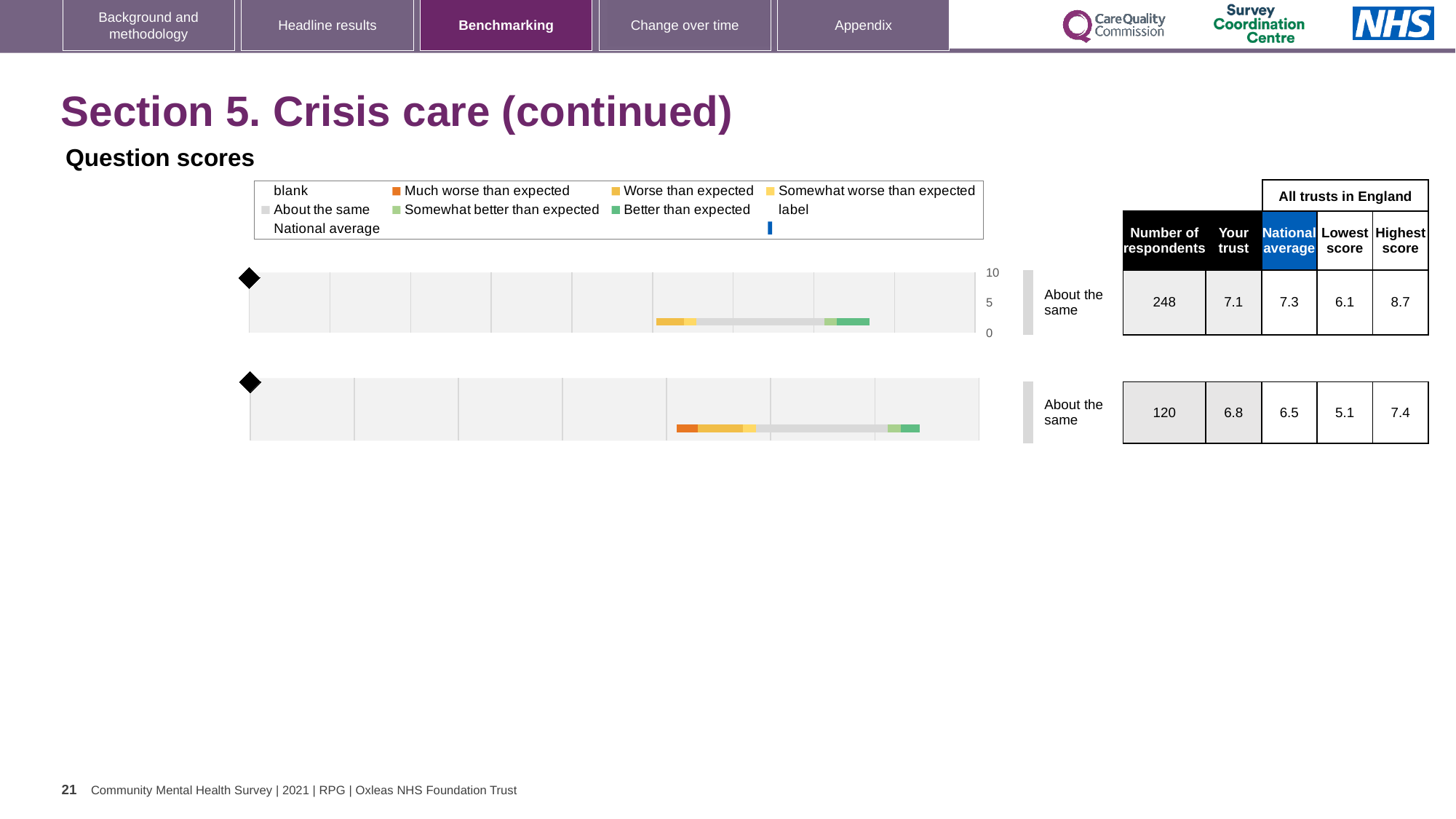
For the bottom chart's row in the table, what is the lowest score among all trusts in England? 5.1 How many benchmarking charts are shown on the slide? 2 For the bottom chart's row, which is larger: the 'Your trust' score or the national average? Your trust For the top chart's row in the table, how many respondents are there? 248 What kind of chart is the top chart on the slide? bar chart For the top chart's row, which is larger: the 'Your trust' score or the national average? National average In the legend, what colour represents 'Much worse than expected'? Orange What benchmark category label is shown next to the bottom chart? About the same For the top chart's row in the table, what is the 'Your trust' score? 7.1 For the top chart's row in the table, what is the national average score? 7.3 For the top chart's row, what is the difference between the highest score and the lowest score among all trusts in England? 2.6 For the bottom chart's row in the table, what is the 'Your trust' score? 6.8